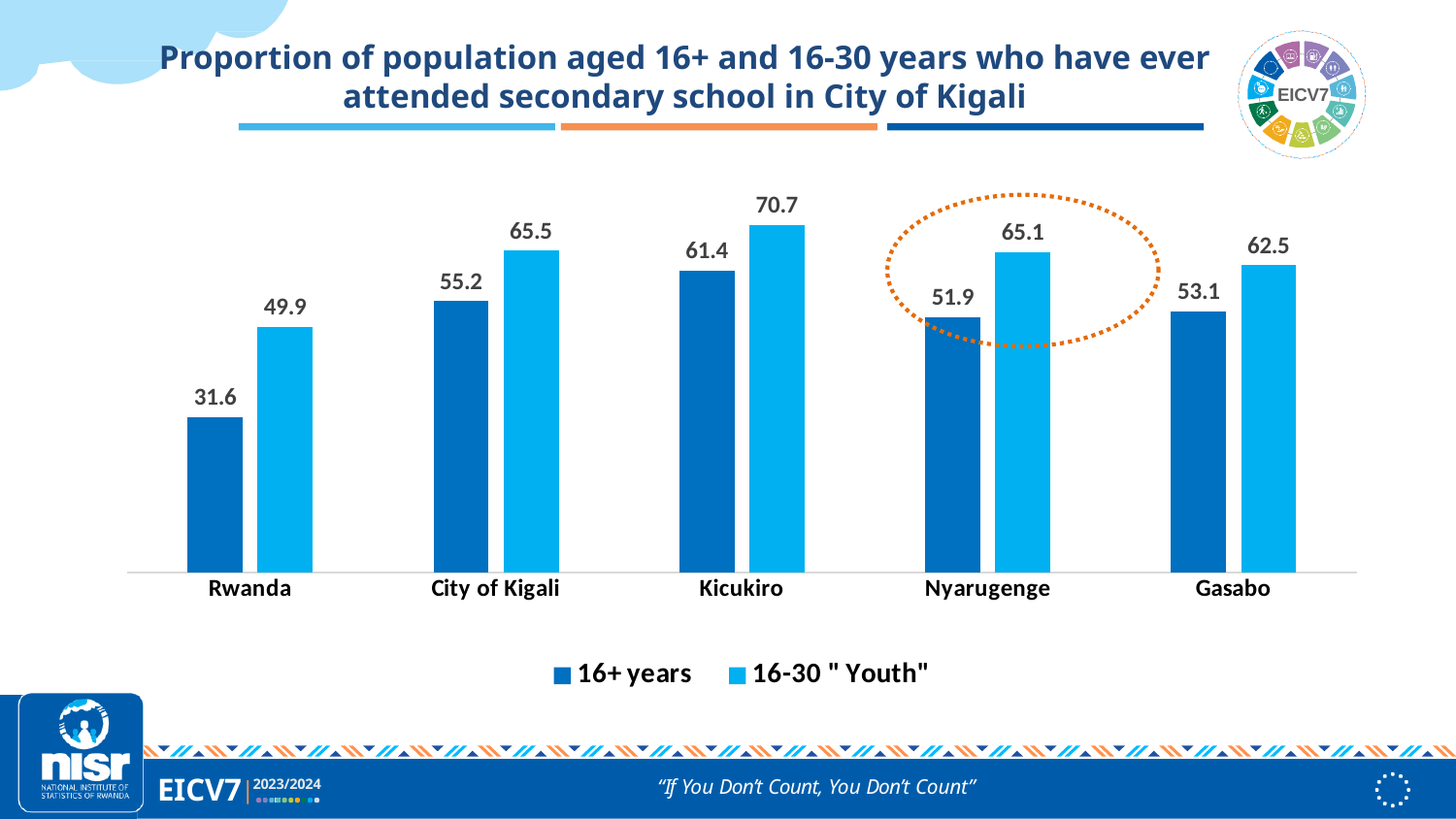
What kind of chart is shown on the slide? Bar chart What is the value for 16+ years in Nyarugenge? 51.9 What is the value for 16-30 "Youth" in Kicukiro? 70.7 What is the value for 16-30 "Youth" in Gasabo? 62.5 Which category is highlighted with a dotted orange circle? Nyarugenge What is the difference between the 16-30 "Youth" and 16+ years values for City of Kigali? 10.3 Which is larger: the 16+ years value for Kicukiro or the 16+ years value for Gasabo? Kicukiro Which category has the highest value for 16-30 "Youth"? Kicukiro Which category has the lowest value for 16+ years? Rwanda What is the value for 16+ years in Rwanda? 31.6 How many categories are shown on the x axis? 5 How many series does the legend list? 2